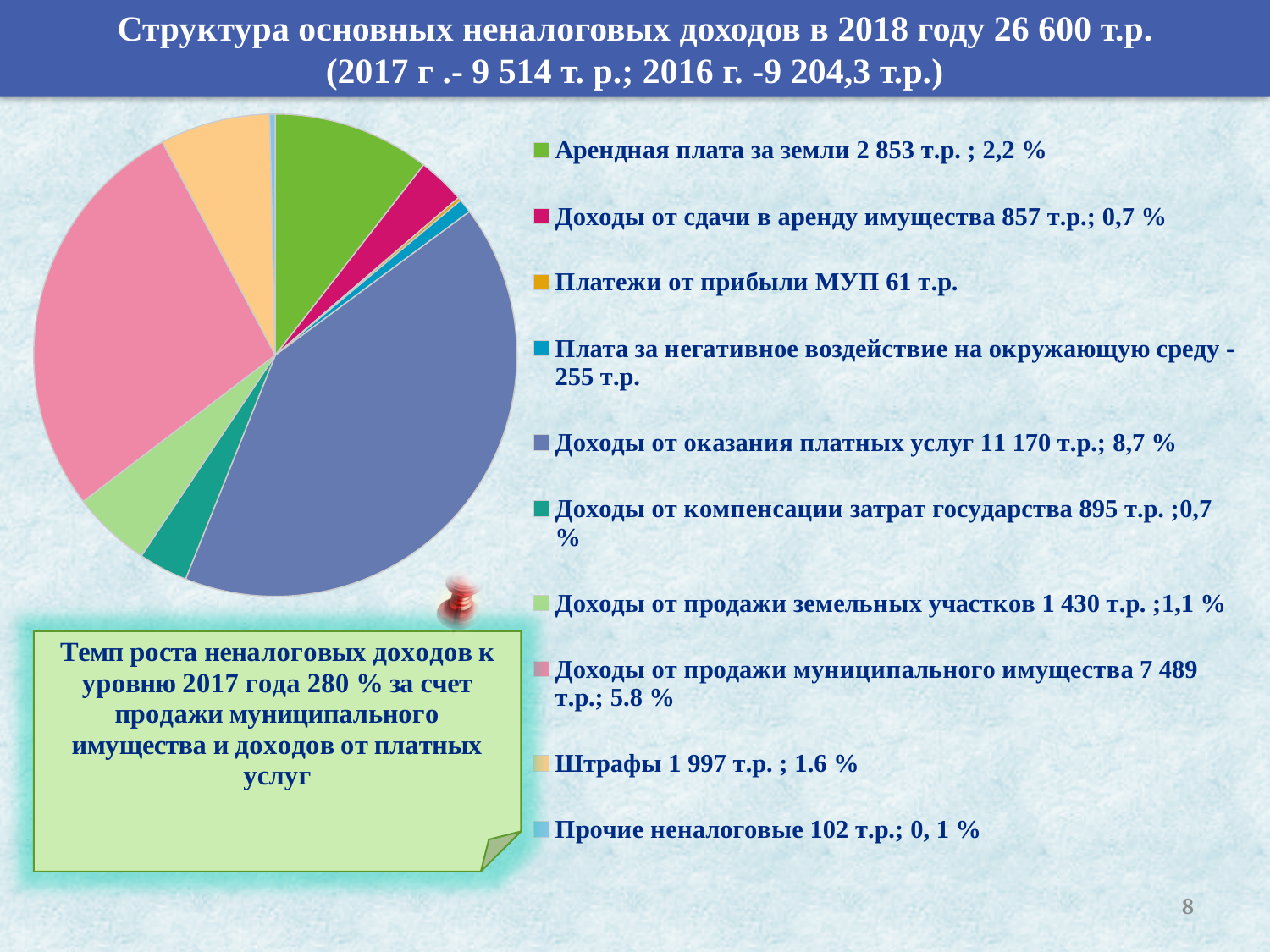
Which category has the smallest value in the pie chart? Платежи от прибыли МУП What kind of chart is shown on the slide? pie chart What is the value for Доходы от продажи муниципального имущества? 7 489 т.р. What percentage is shown for Арендная плата за земли? 2,2 % What is the difference between Доходы от оказания платных услуг and Доходы от продажи муниципального имущества? 3 681 т.р. What is the value for Доходы от оказания платных услуг? 11 170 т.р. How many categories does the legend of the pie chart list? 10 What colour is the slice for Доходы от продажи муниципального имущества? pink What total amount of non-tax revenue for 2018 is given in the chart title? 26 600 т.р. What is the value for Платежи от прибыли МУП? 61 т.р. Which is larger: Штрафы or Доходы от продажи земельных участков? Штрафы Which category has the largest value in the pie chart? Доходы от оказания платных услуг